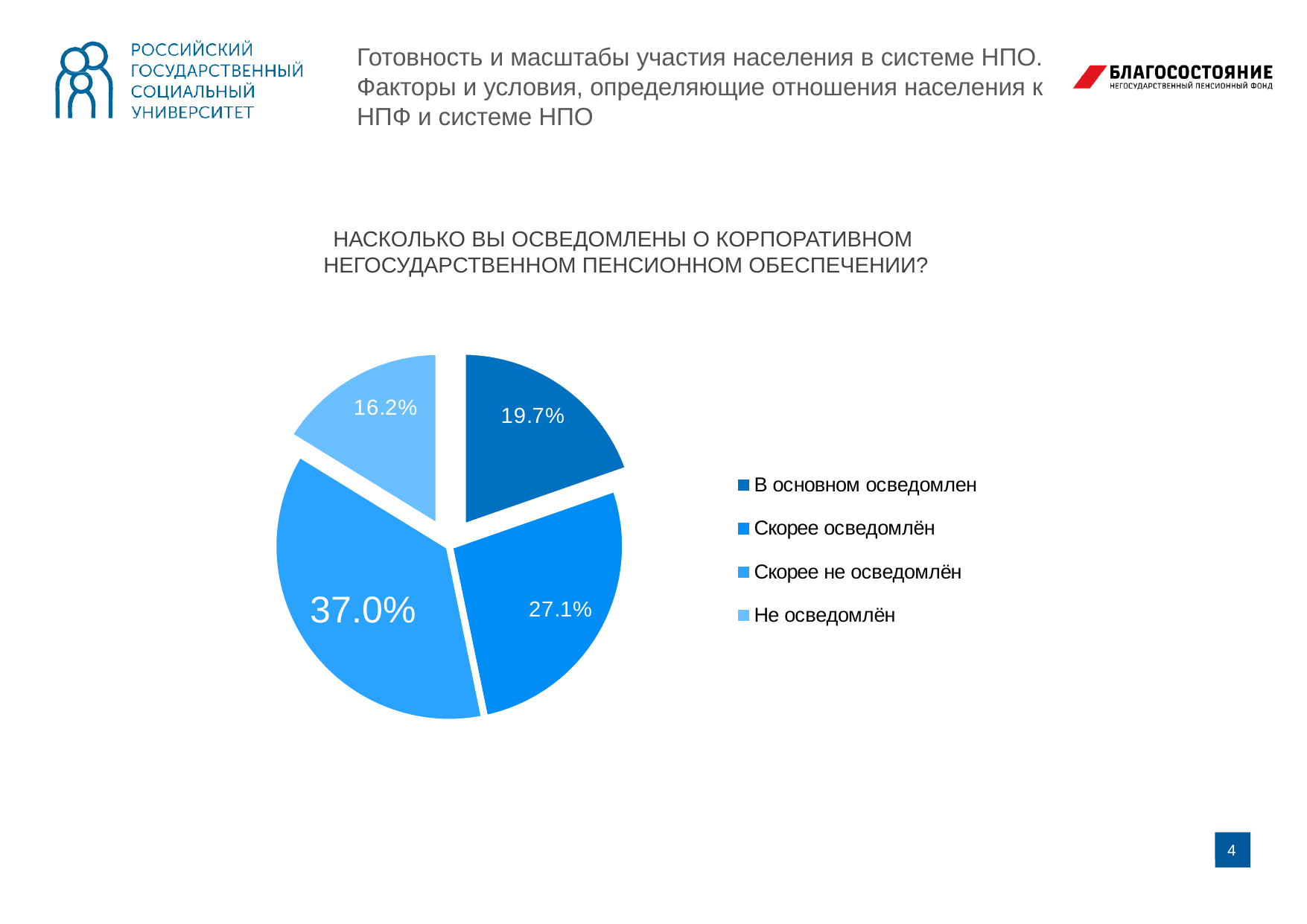
Which is larger: the share for "В основном осведомлен" or the share for "Не осведомлён"? В основном осведомлен What kind of chart is shown on the slide? pie chart How many slices does the pie chart have? 4 How many entries does the legend list? 4 What share of respondents answered "Не осведомлён"? 16.2% Which answer option has the largest share of the pie? Скорее не осведомлён What is the difference in percentage points between "Скорее не осведомлён" and "Скорее осведомлён"? 9.9 What share of respondents answered "Скорее осведомлён"? 27.1% Which answer option has the smallest share of the pie? Не осведомлён What is the title of the chart? НАСКОЛЬКО ВЫ ОСВЕДОМЛЕНЫ О КОРПОРАТИВНОМ НЕГОСУДАРСТВЕННОМ ПЕНСИОННОМ ОБЕСПЕЧЕНИИ? What share of respondents answered "Скорее не осведомлён"? 37.0% What share of respondents answered "В основном осведомлен"? 19.7%